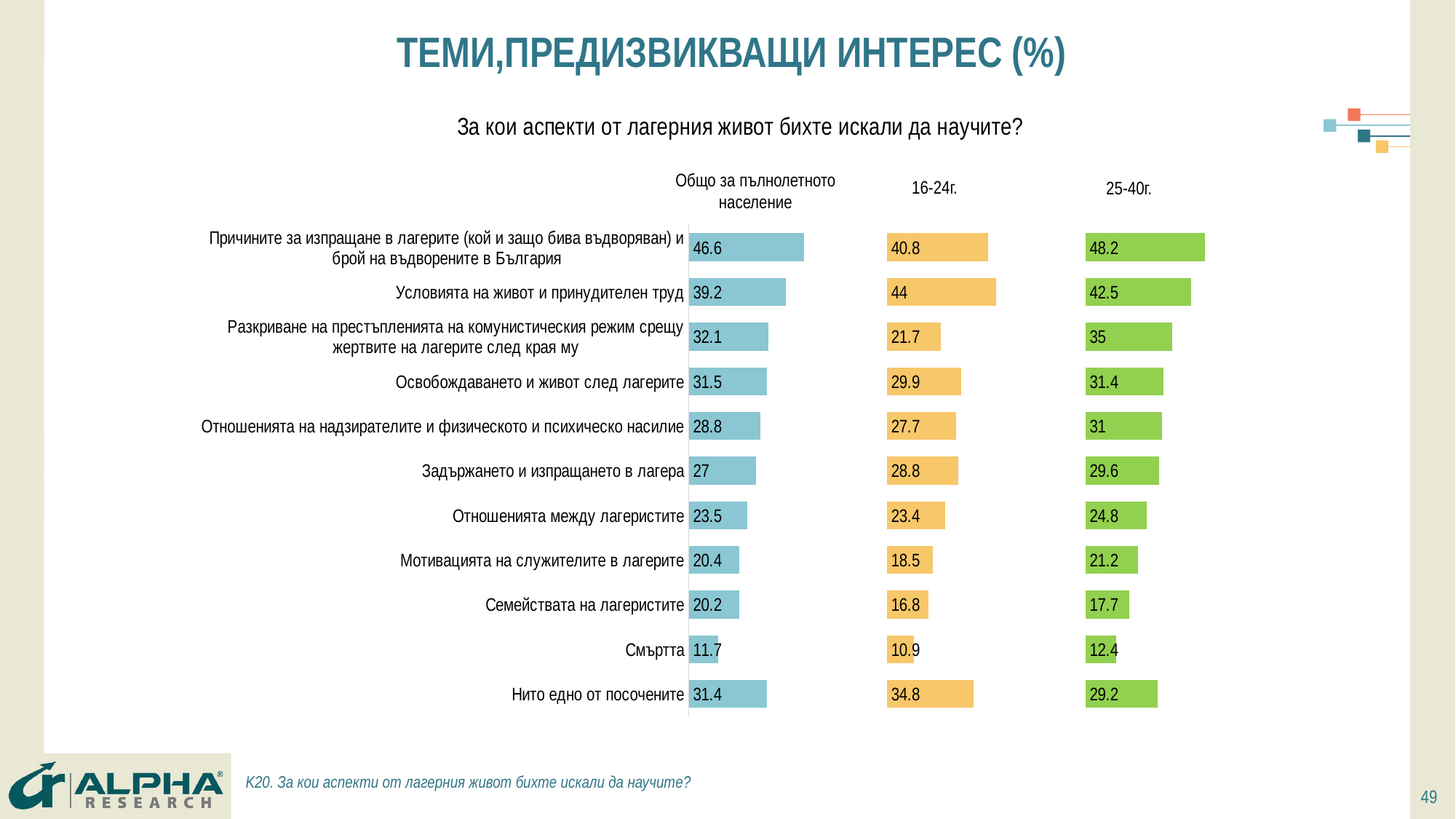
In the chart for "25-40г.", which category has the highest value? Причините за изпращане в лагерите (кой и защо бива въдворяван) и брой на въдворените в България What is the title of the slide? ТЕМИ,ПРЕДИЗВИКВАЩИ ИНТЕРЕС (%) In the chart for "16-24г.", what is the difference between "Нито едно от посочените" and "Разкриване на престъпленията на комунистическия режим срещу жертвите на лагерите след края му"? 13.1 In the chart for "16-24г.", what is the value for "Условията на живот и принудителен труд"? 44 How many categories are listed in the chart for "Общо за пълнолетното население"? 11 In the chart for "25-40г.", what is the value for "Нито едно от посочените"? 29.2 In the chart for "Общо за пълнолетното население", which is larger: "Условията на живот и принудителен труд" or "Освобождаването и живот след лагерите"? Условията на живот и принудителен труд What type of chart is used on this slide? Bar chart For "Семействата на лагеристите", which is larger: the value in the "16-24г." chart or the value in the "25-40г." chart? 25-40г. In the chart for "25-40г.", what is the difference between "Причините за изпращане в лагерите (кой и защо бива въдворяван) и брой на въдворените в България" and "Смъртта"? 35.8 In the chart for "16-24г.", which category has the lowest value? Смъртта In the chart for "Общо за пълнолетното население", what is the value for "Смъртта"? 11.7